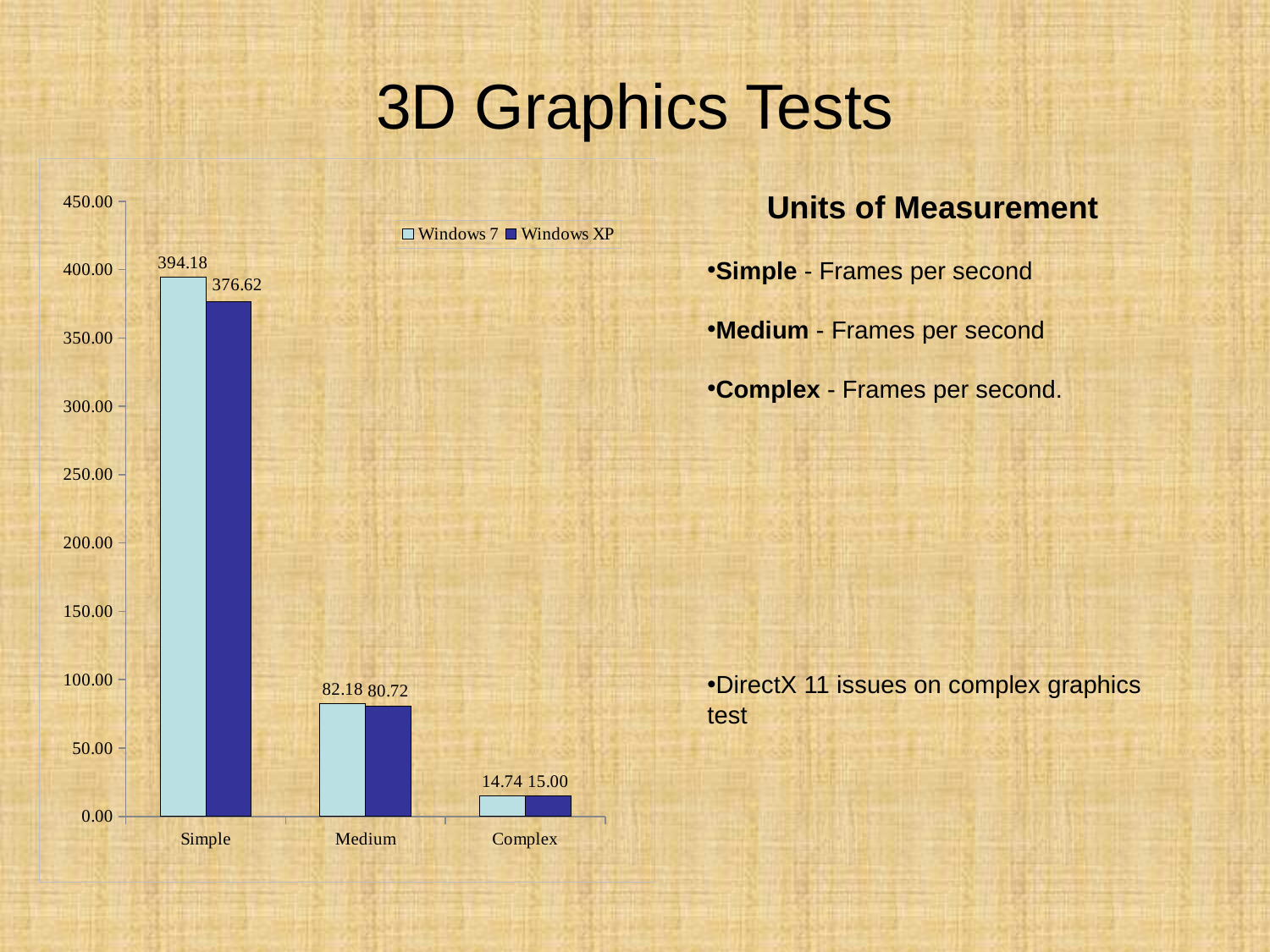
Do the Windows 7 values rise or fall from Simple to Complex? Fall What kind of chart is shown on the slide? Bar chart Which test has the highest Windows 7 value? Simple For the Medium test, which is larger: Windows 7 or Windows XP? Windows 7 What is the Windows XP value for the Medium test? 80.72 Is the Windows XP value for the Simple test greater or less than 350.00? greater How many test categories are shown on the x axis? 3 What is the difference between the Windows 7 and Windows XP values for the Simple test? 17.56 How many series does the legend list? 2 What is the Windows 7 value for the Simple test? 394.18 What is the Windows XP value for the Complex test? 15.00 Which test has the lowest Windows XP value? Complex